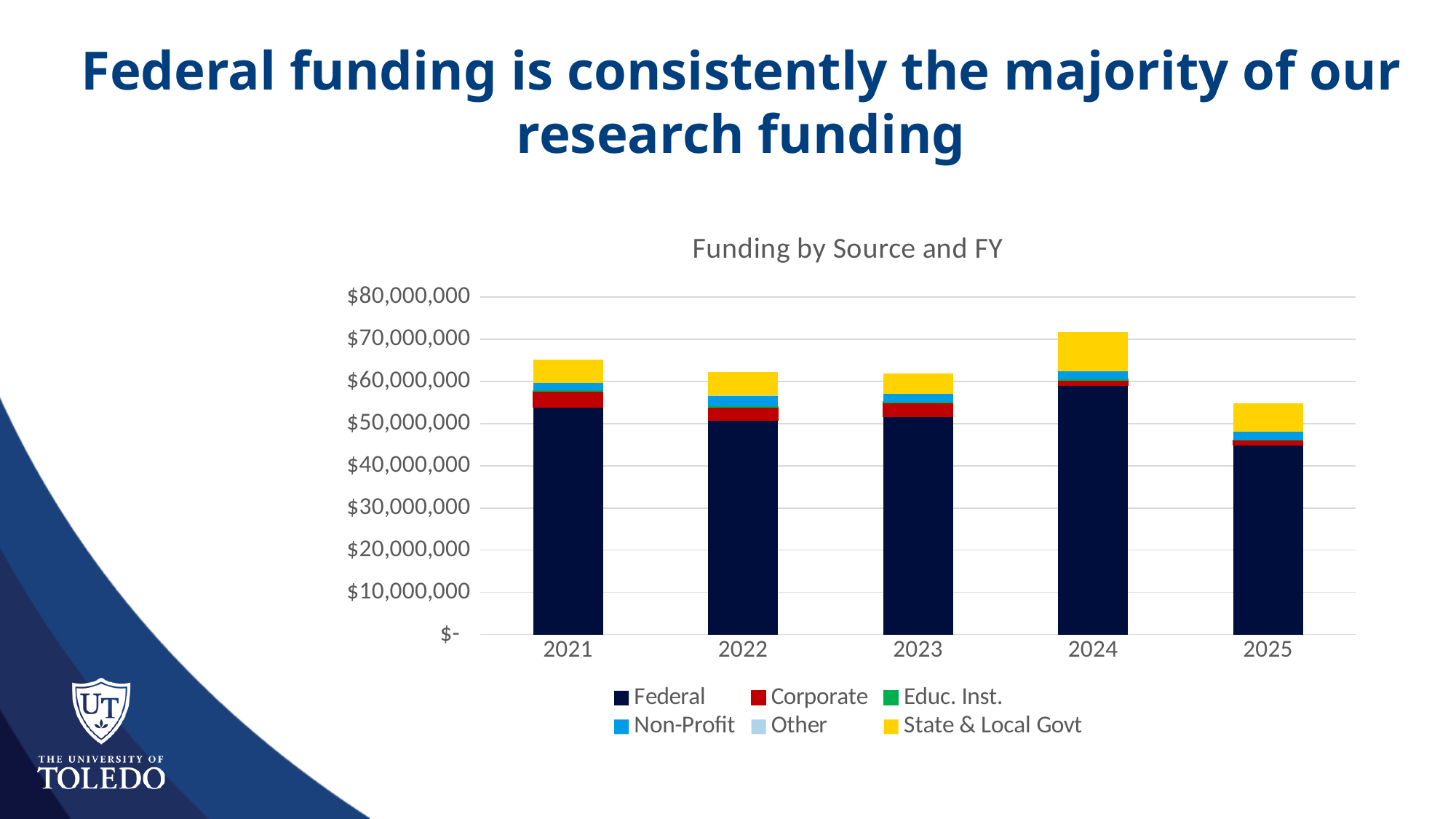
Which fiscal year has the highest total funding? 2024 Which year has the larger total funding, 2021 or 2022? 2021 How many fiscal years are shown on the x axis of the chart? 5 What kind of chart is shown on the slide? Stacked bar chart Which colour represents State & Local Govt in the chart? Yellow Which fiscal year has the lowest total funding? 2025 Is the Federal funding for 2025 greater or less than $50,000,000? less Does total funding rise or fall from 2024 to 2025? fall Is the total funding for 2025 greater or less than $60,000,000? less How many funding sources does the legend list? 6 What is the title of the chart? Funding by Source and FY Is the total funding for 2024 greater or less than $70,000,000? greater